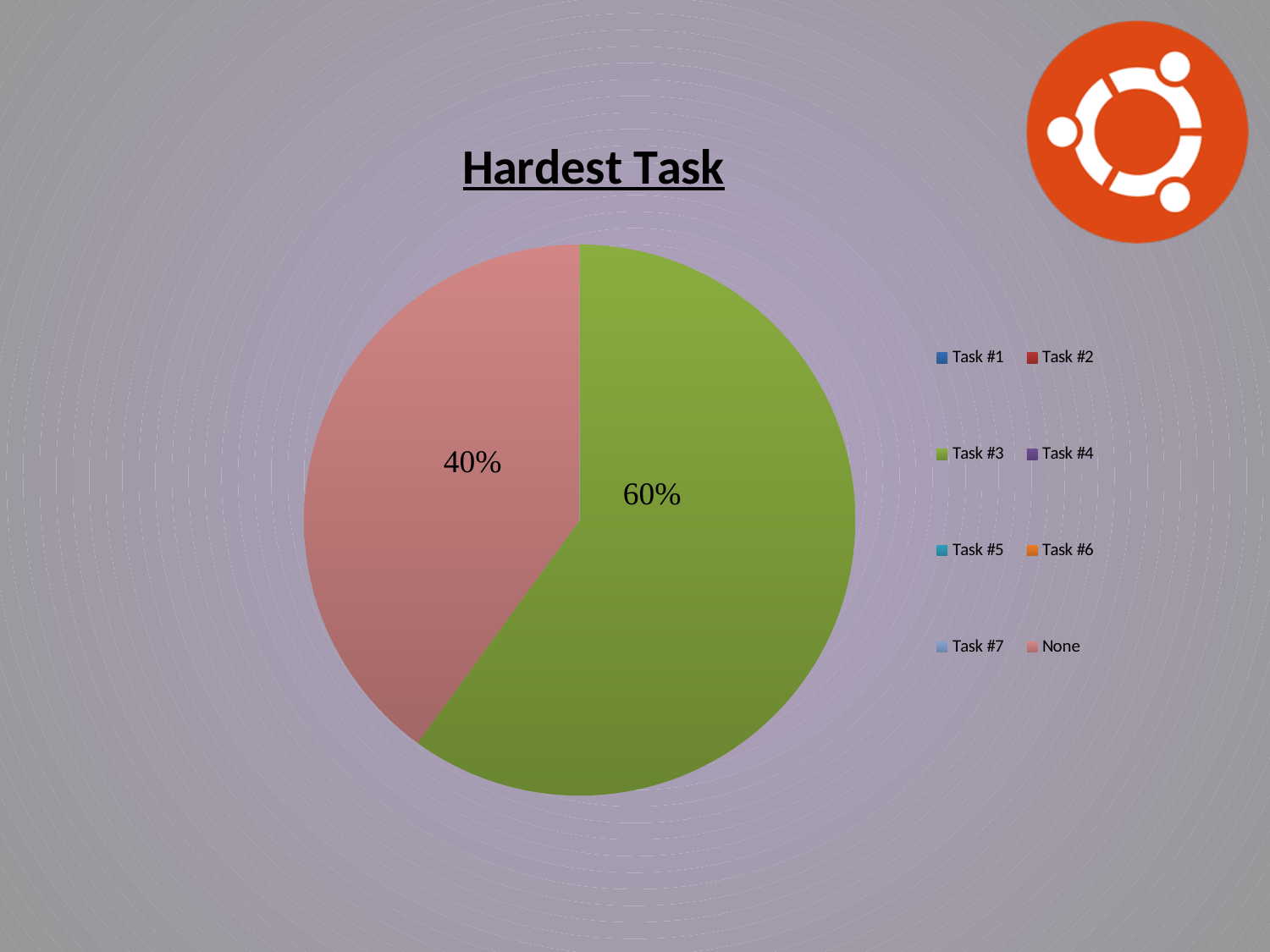
What kind of chart is shown on the slide? pie chart What is the title of the chart? Hardest Task What share of the pie does Task #3 take? 60% Which is larger, the slice for Task #3 or the slice for None? Task #3 What colour is the slice for Task #3? green Is the share for Task #3 greater or less than 50%? greater Which category has the largest slice of the pie? Task #3 What share of the pie does None take? 40% How many entries does the legend list? 8 How many slices are visible in the pie? 2 What is the difference in percentage points between the Task #3 slice and the None slice? 20%